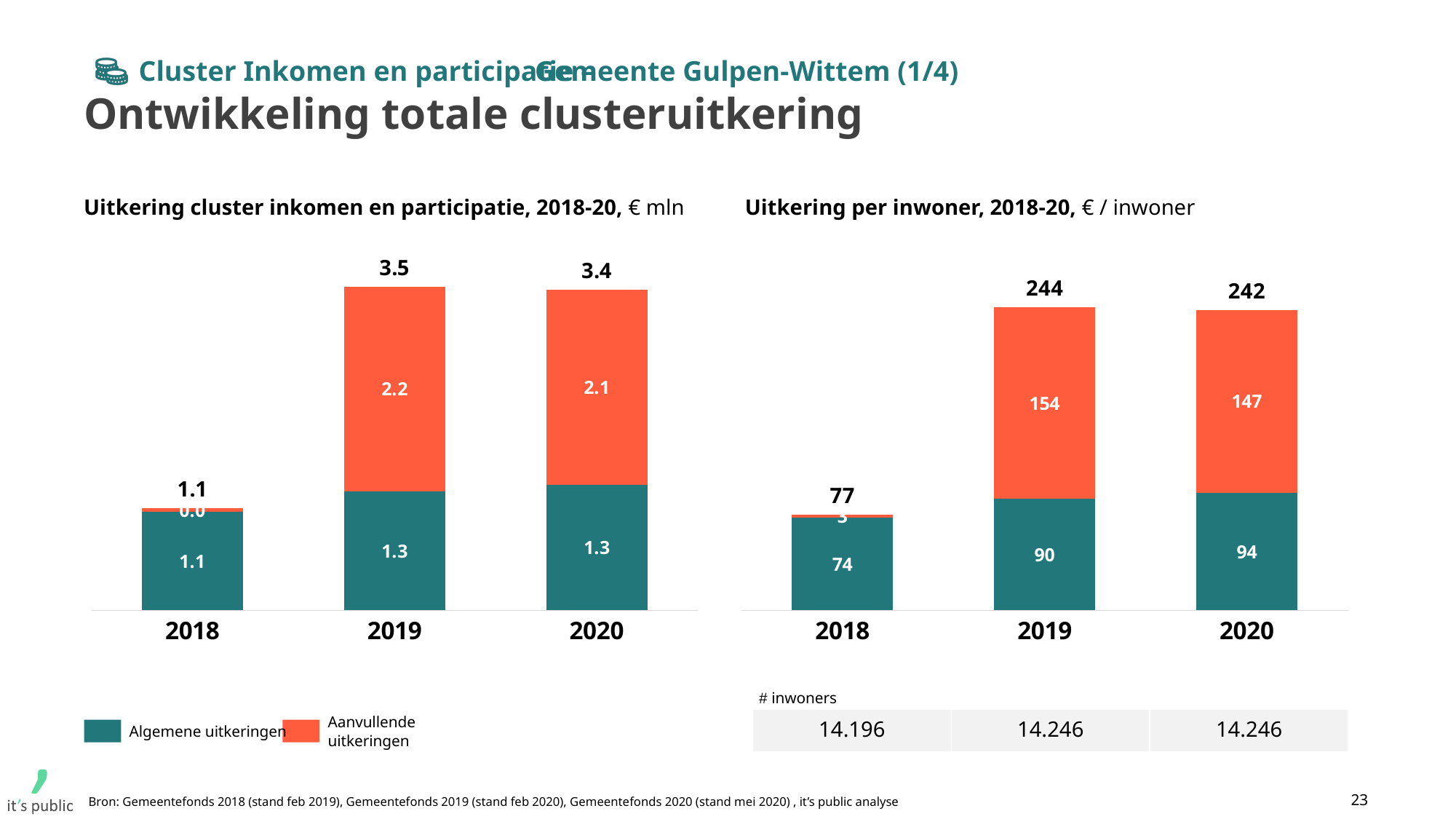
How many years are shown on the x axis of the left chart (Uitkering cluster inkomen en participatie)? 3 In the left chart (Uitkering cluster inkomen en participatie), what is the value of Algemene uitkeringen in 2020? 1.3 In the left chart (Uitkering cluster inkomen en participatie), which year has the lowest total? 2018 In the right chart (Uitkering per inwoner), is the Algemene uitkeringen value larger in 2019 or in 2020? 2020 What type of chart is the right chart (Uitkering per inwoner)? Stacked bar chart In the left chart (Uitkering cluster inkomen en participatie), what is the total value for 2019? 3.5 In the left chart (Uitkering cluster inkomen en participatie), what is the value of Aanvullende uitkeringen in 2019? 2.2 How many series does the legend list for the charts? 2 In the right chart (Uitkering per inwoner), which year has the highest total? 2019 In the right chart (Uitkering per inwoner), what is the difference between the totals for 2019 and 2018? 167 In the right chart (Uitkering per inwoner), what is the value of Aanvullende uitkeringen in 2020? 147 In the right chart (Uitkering per inwoner), what is the value of Algemene uitkeringen in 2018? 74